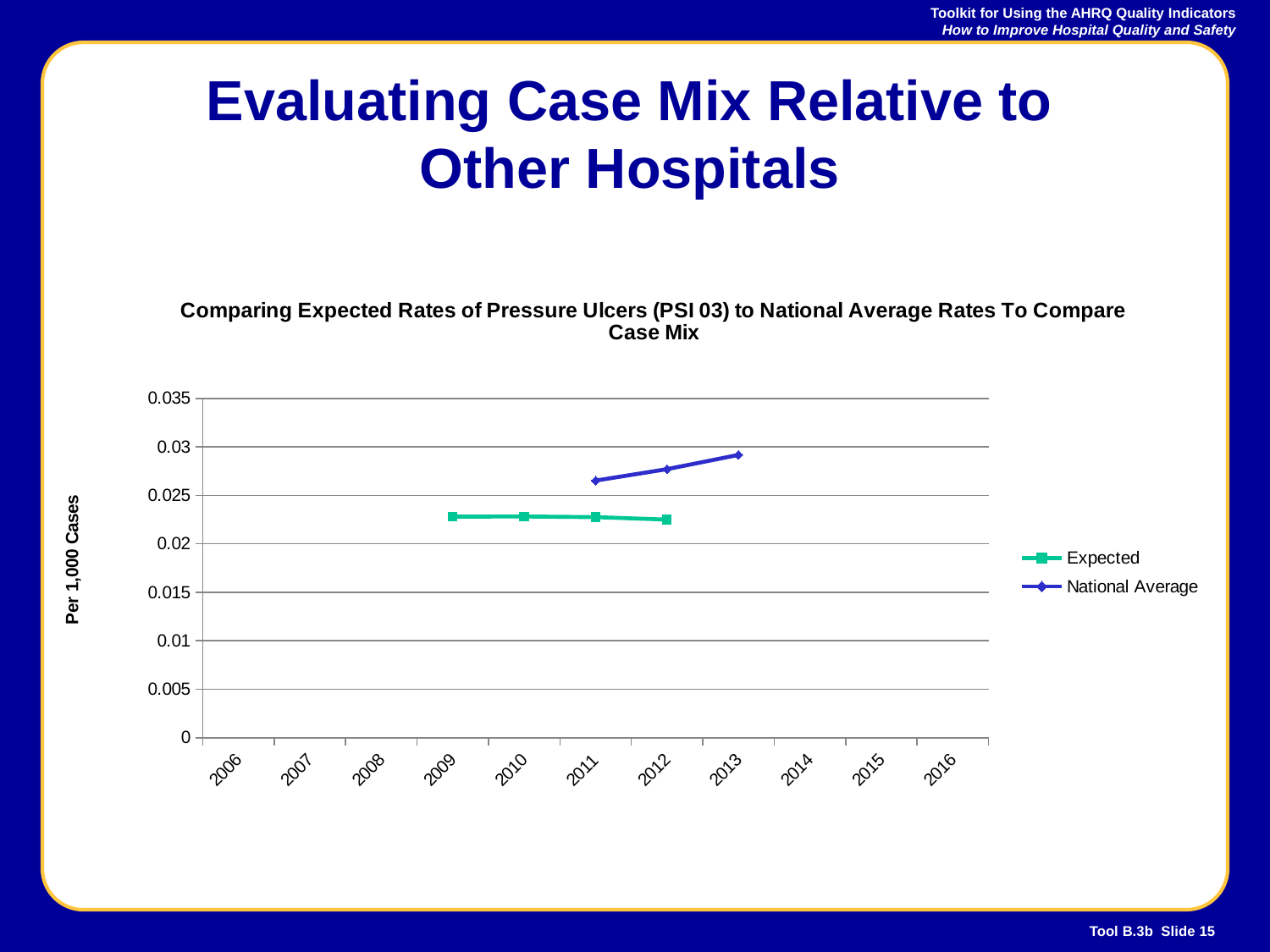
How many years are labelled along the x axis? 11 What kind of chart is shown on the slide? line chart Is the National Average value for 2011 greater or less than 0.025? greater Does the National Average line rise or fall from 2011 to 2013? rises Is the National Average value for 2013 greater or less than 0.03? less Is the Expected value for 2009 greater or less than 0.025? less In 2012, which is larger: the Expected value or the National Average value? National Average What are the two series named in the legend? Expected and National Average How many data points does the Expected series have? 4 How many series does the legend list? 2 How many data points does the National Average series have? 3 What is the label on the vertical axis? Per 1,000 Cases